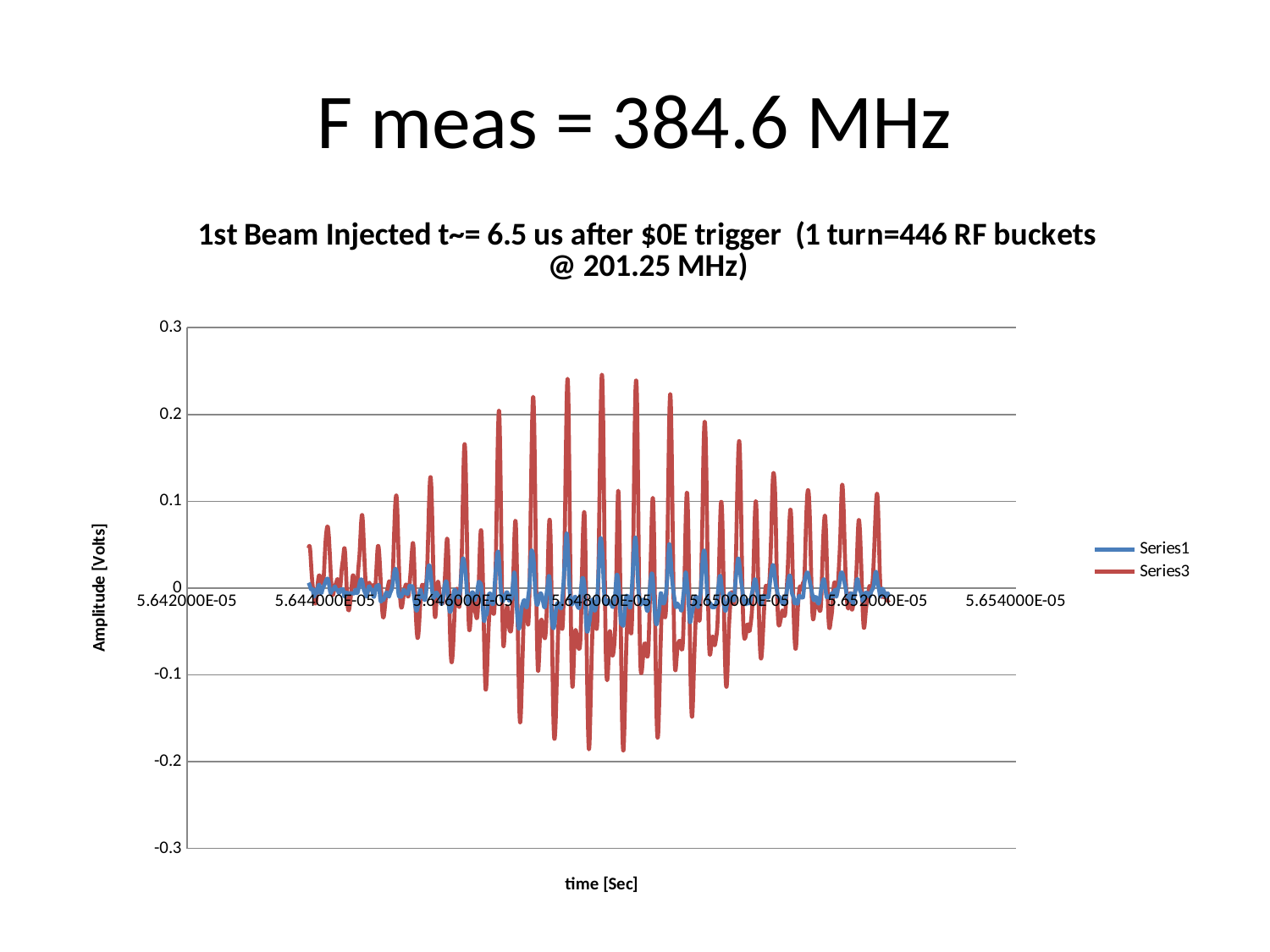
Which series reaches larger peak amplitudes, Series1 or Series3? Series3 What kind of chart is shown on the slide? line chart What are the names of the series listed in the legend? Series1 and Series3 How many series does the legend list? 2 Is the lowest value of Series3 greater or less than -0.1? less Is the highest peak of Series3 greater or less than 0.2? greater What is the label of the y axis? Amplitude [Volts] Do the peak amplitudes of Series3 increase or decrease along the x axis from 5.644000E-05 to 5.648000E-05? increase Is the highest peak of Series3 greater or less than 0.3? less Do the peak amplitudes of Series3 increase or decrease along the x axis from 5.648000E-05 to 5.652000E-05? decrease